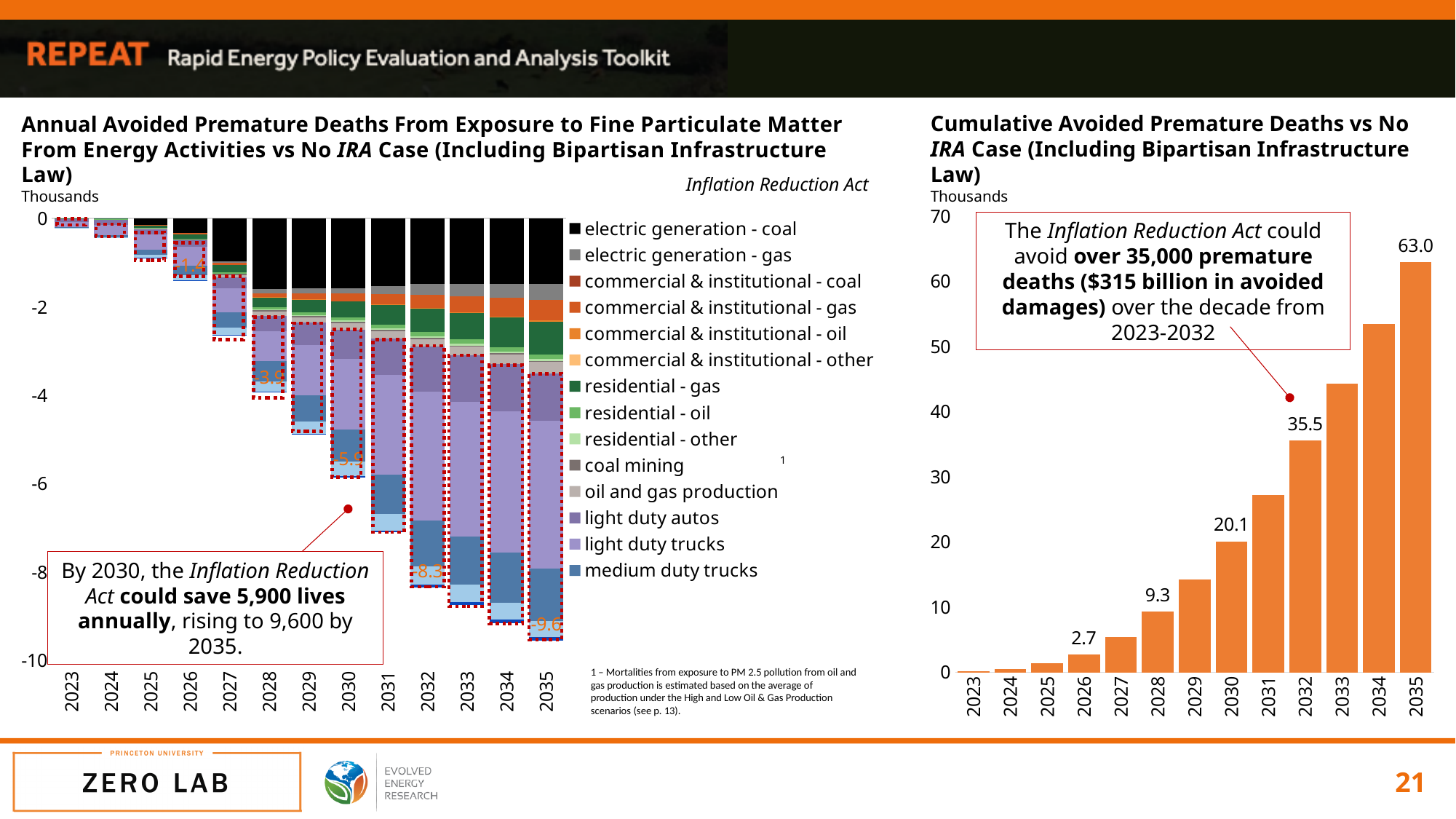
In the Cumulative Avoided Premature Deaths chart on the right, what is the value for 2035? 63.0 In the Cumulative Avoided Premature Deaths chart on the right, do the values rise or fall from 2023 to 2035? rise In the Cumulative Avoided Premature Deaths chart on the right, what is the difference between the 2032 value and the 2028 value? 26.2 In the Cumulative Avoided Premature Deaths chart on the right, which year has the highest value? 2035 In the Cumulative Avoided Premature Deaths chart on the right, is the value for 2034 greater or less than 50? greater In the Annual Avoided Premature Deaths chart on the left, what total value is labelled for 2030? -5.9 How many series does the legend list in the Annual Avoided Premature Deaths chart on the left? 14 In the Cumulative Avoided Premature Deaths chart on the right, is the value for 2033 greater or less than 40? greater In the Annual Avoided Premature Deaths chart on the left, what total value is labelled for 2035? -9.6 How many years are shown on the x axis of the Cumulative Avoided Premature Deaths chart on the right? 13 In the Cumulative Avoided Premature Deaths chart on the right, what is the value for 2030? 20.1 What kind of chart is the Annual Avoided Premature Deaths chart on the left? stacked bar chart